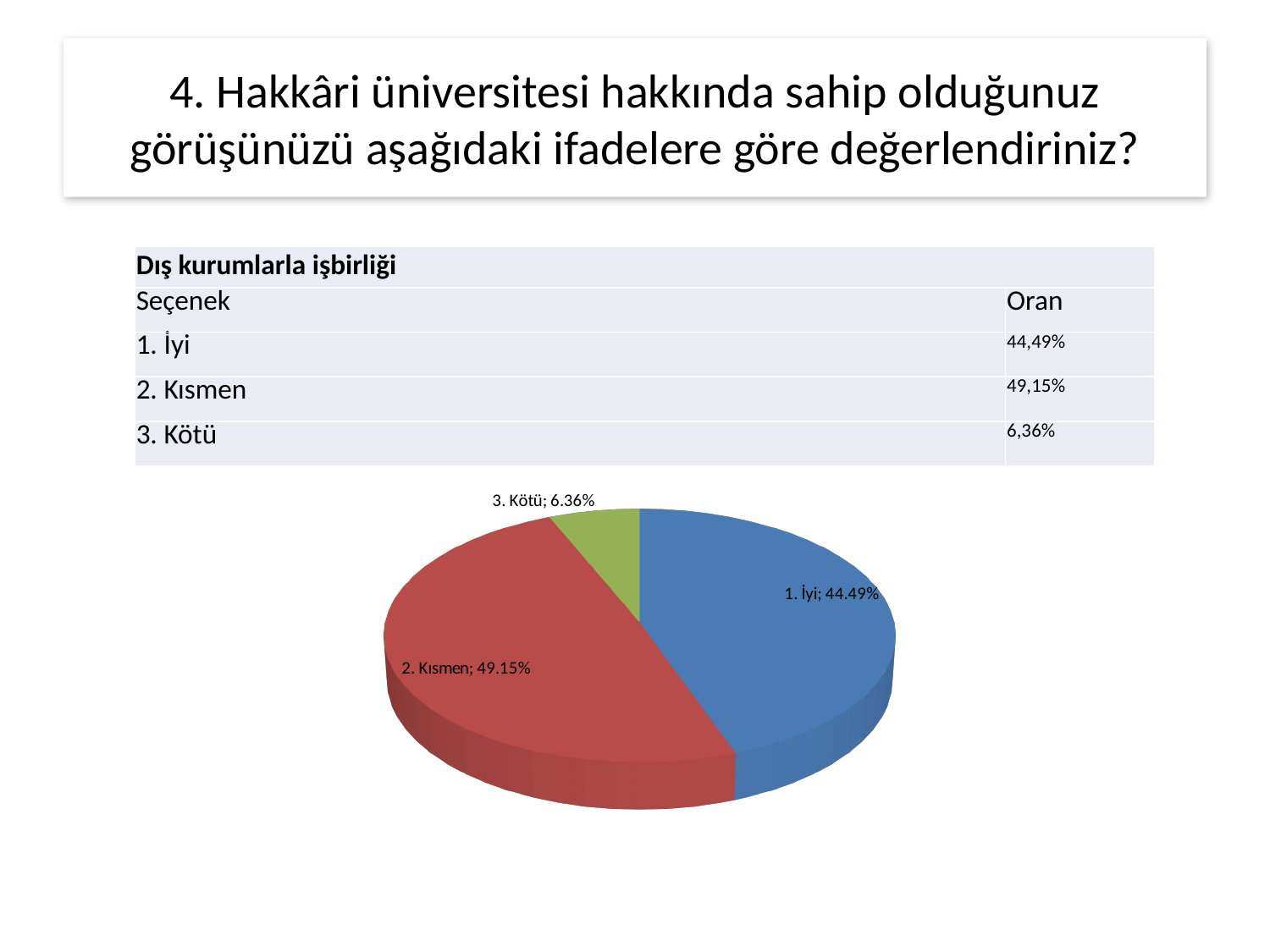
What type of chart is shown on the slide? pie chart What colour is the "2. Kısmen" slice in the pie chart? red What is the difference between the "1. İyi" and "3. Kötü" values in the pie chart? 38.13% In the pie chart, which is larger: the slice for "1. İyi" or the slice for "3. Kötü"? 1. İyi How many slices does the pie chart have? 3 Which slice of the pie chart is the largest? 2. Kısmen What is the value shown for the slice labelled "3. Kötü" in the pie chart? 6.36% Which slice of the pie chart is the smallest? 3. Kötü What is the difference between the "2. Kısmen" and "1. İyi" values in the pie chart? 4.66% What is the value shown for the slice labelled "2. Kısmen" in the pie chart? 49.15% What colour is the "3. Kötü" slice in the pie chart? green What is the value shown for the slice labelled "1. İyi" in the pie chart? 44.49%